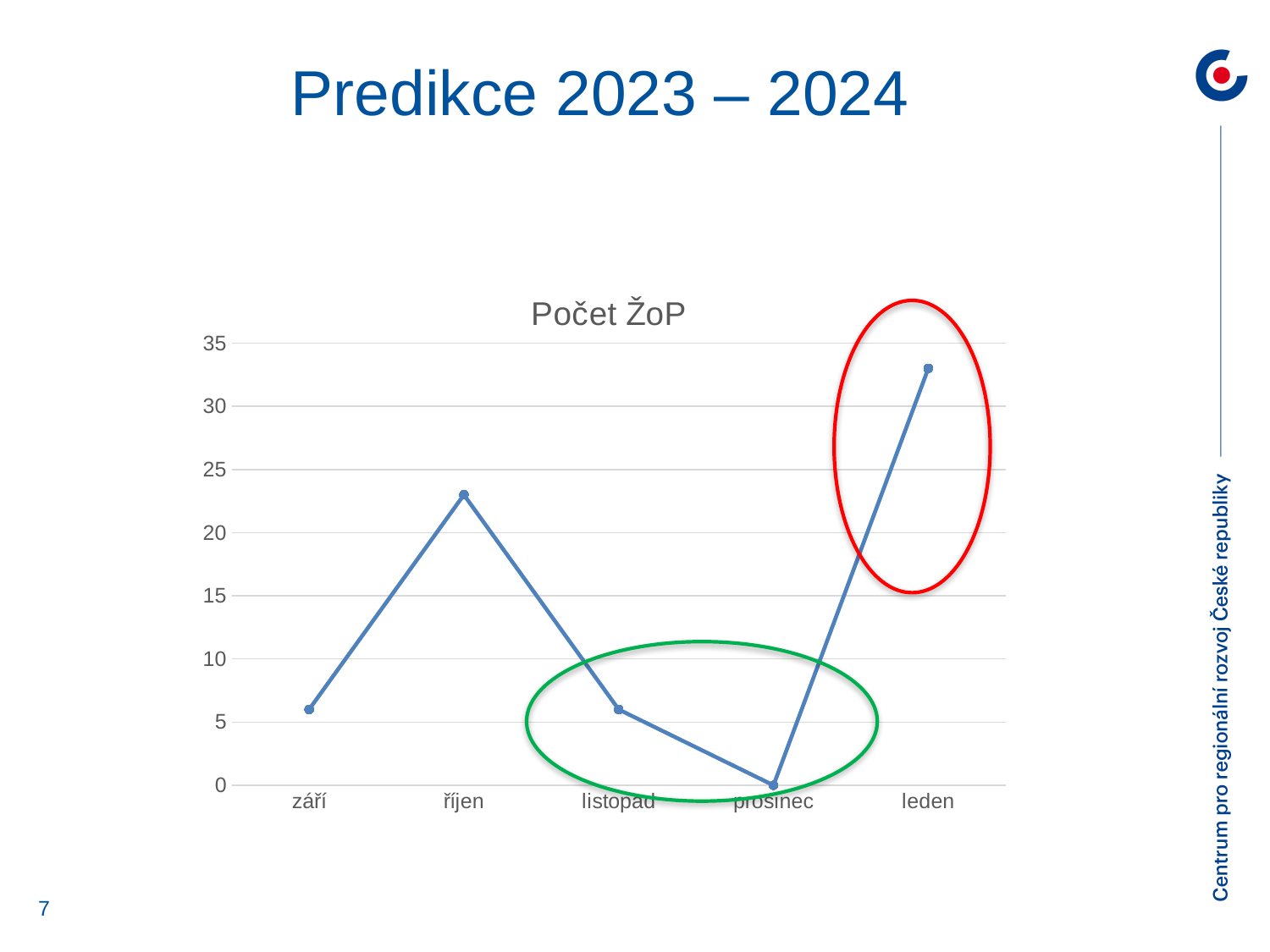
How many months are plotted on the x axis of the chart? 5 What colour is the oval drawn around the leden point? red Which month has the highest value in the chart? leden What is the title of the chart? Počet ŽoP Which month has the lowest value in the chart? prosinec What is the value for prosinec? 0 Is the value for listopad greater or less than 10? less What type of chart is shown on the slide? line chart Which is larger, the value for říjen or the value for listopad? říjen Is the value for říjen greater or less than 20? greater Is the value for leden greater or less than 30? greater Does the value rise or fall from prosinec to leden? rise